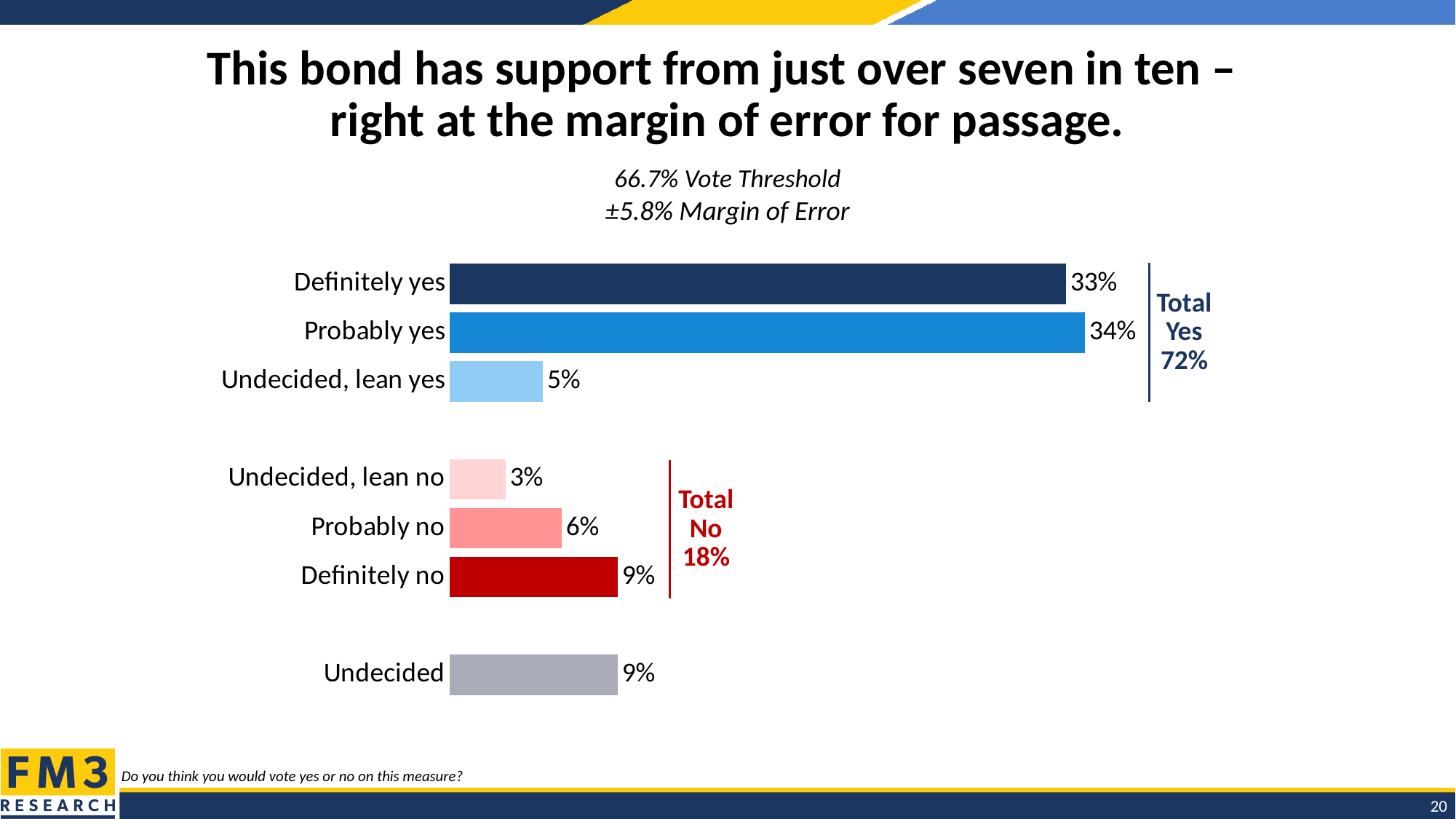
What is the Total Yes percentage shown on the chart? 72% What is the difference between "Definitely yes" and "Definitely no"? 24% Which is larger, "Probably no" or "Undecided, lean yes"? Probably no Which response category has the highest percentage? Probably yes What is the value for "Undecided, lean no"? 3% What is the value for "Definitely no"? 9% What percentage of respondents said "Probably yes"? 34% How many response categories are shown in the chart? 7 What is the Total No percentage shown on the chart? 18% Which response category has the lowest percentage? Undecided, lean no What percentage of respondents said "Definitely yes"? 33% What kind of chart is shown on the slide? Bar chart